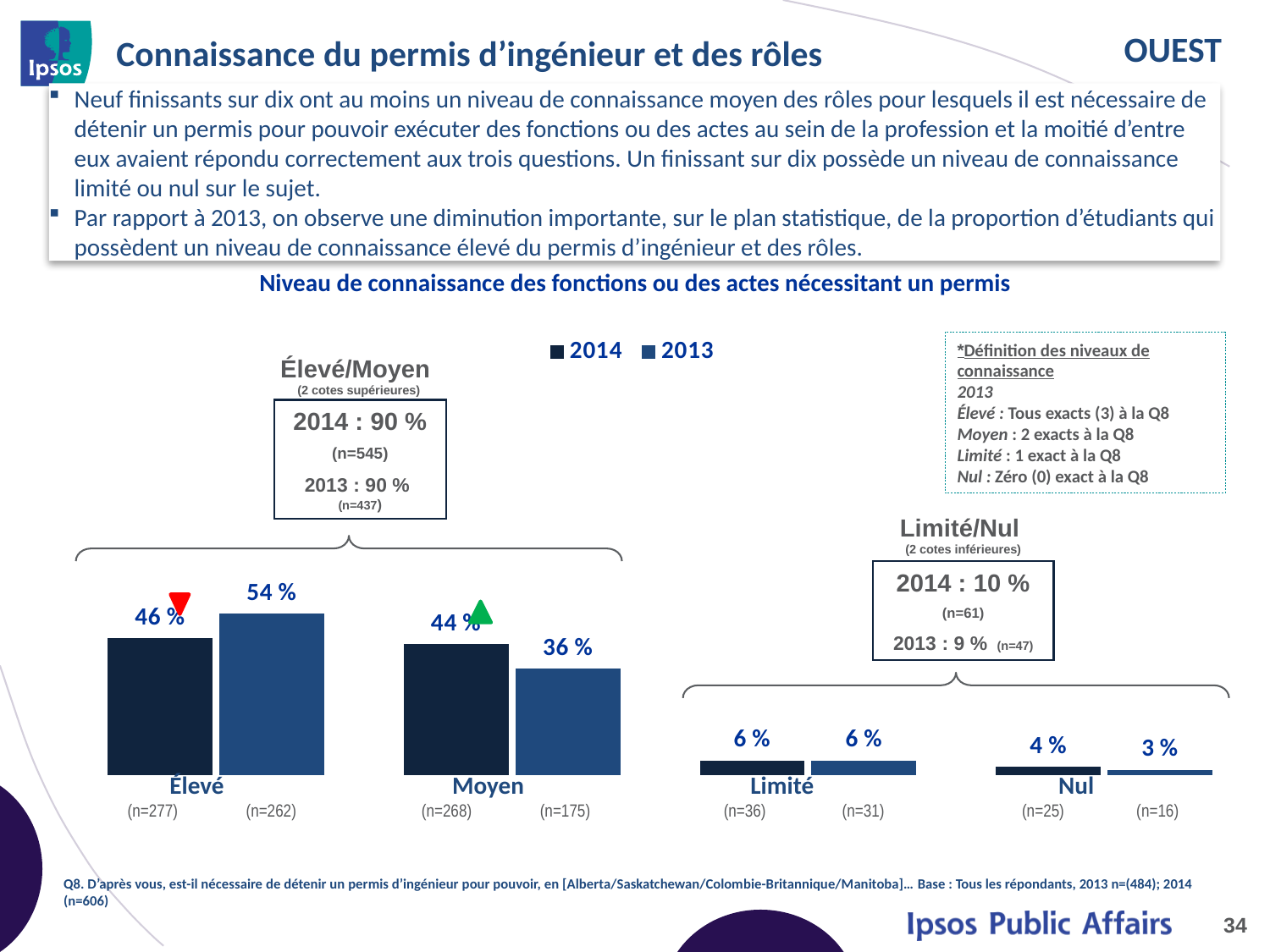
Which category has the highest 2013 value? Élevé What kind of chart is shown? bar chart What is the 2013 value for Moyen? 36 % How many categories are shown on the x axis? 4 What is the 2014 value for Élevé? 46 % What is the difference between the 2013 and 2014 values for Élevé? 8 % Which category has the lowest 2014 value? Nul What is the 2014 value for Nul? 4 % How many series does the legend list? 2 Which is larger for Moyen, the 2014 value or the 2013 value? 2014 What is the difference between the 2014 and 2013 values for Nul? 1 % What are the two series listed in the legend? 2014 and 2013